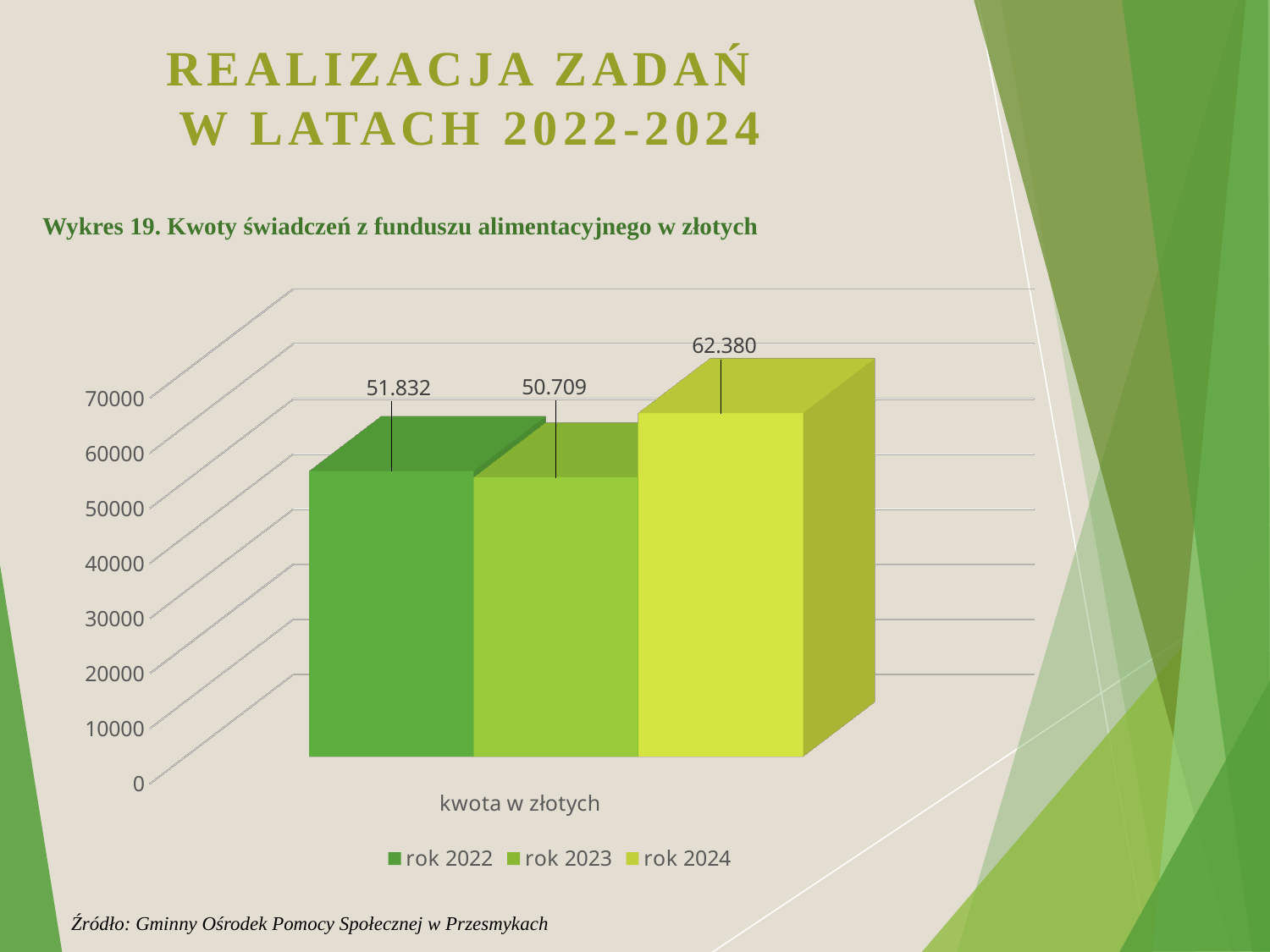
What is the value for rok 2023 in the chart? 50.709 Which year has the highest value in the chart? rok 2024 What kind of chart is shown on the slide? bar chart How many series does the legend list? 3 What is the value for rok 2022 in the chart? 51.832 Which is larger, the value for rok 2022 or rok 2023? rok 2022 Which year has the lowest value in the chart? rok 2023 What is the title of the chart? Wykres 19. Kwoty świadczeń z funduszu alimentacyjnego w złotych Is the value for rok 2024 greater or less than 60000? greater What is the value for rok 2024 in the chart? 62.380 What is the difference between the values for rok 2024 and rok 2022? 10.548 What is the difference between the values for rok 2024 and rok 2023? 11.671